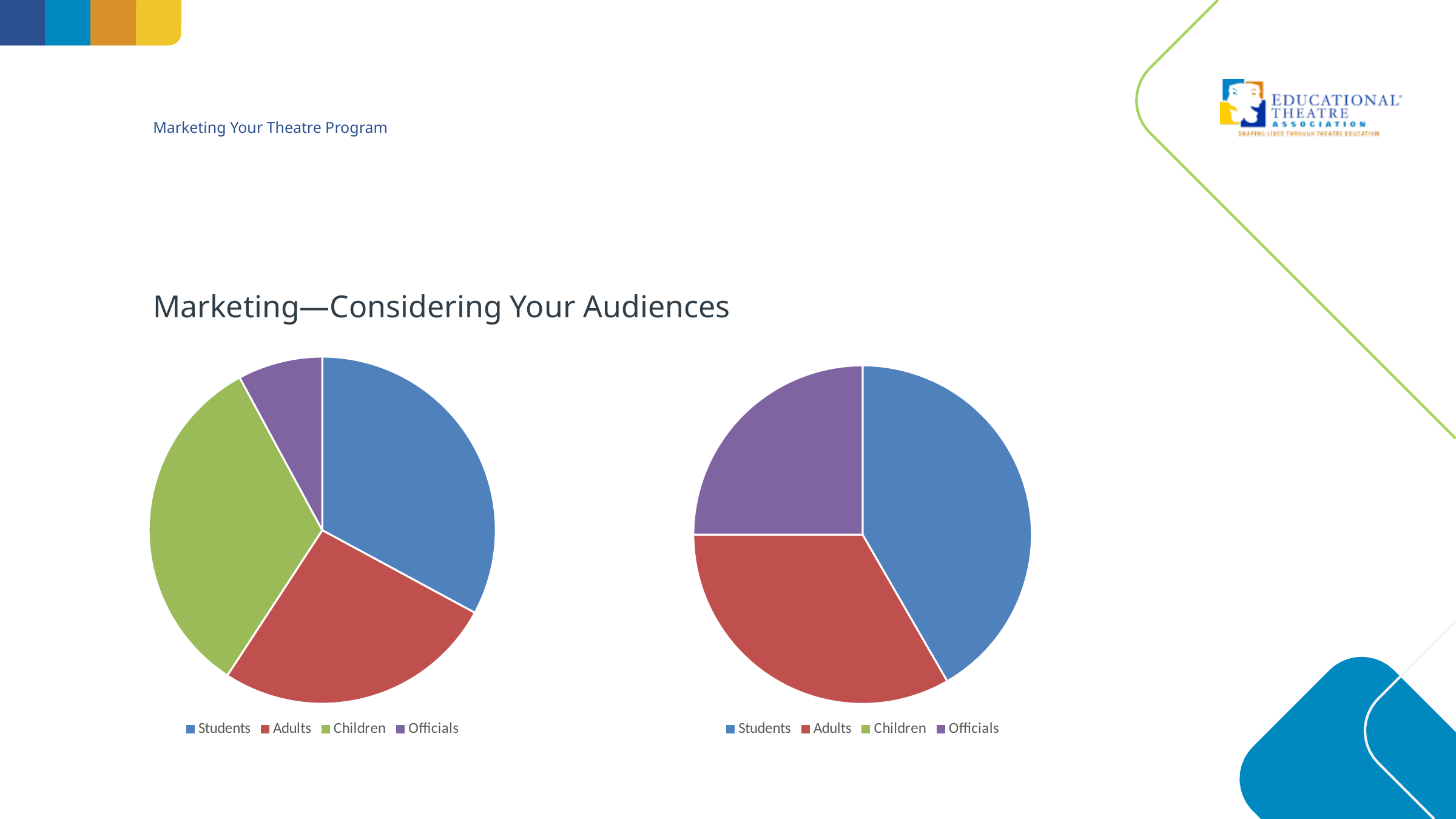
How many entries does the legend of the left pie chart list? 4 In the left pie chart, which slice is larger, Children or Officials? Children What kind of chart is the right chart on the slide? pie chart In the right pie chart, which category has the largest slice? Students In the right pie chart, which slice is larger, Adults or Officials? Adults In the left pie chart, which category has the smallest slice? Officials What is the title shown above the two pie charts? Marketing—Considering Your Audiences In the left pie chart, which slice is larger, Students or Officials? Students What colour represents Children in the legend of the left pie chart? green What kind of chart is the left chart on the slide? pie chart How many slices are visible in the right pie chart? 3